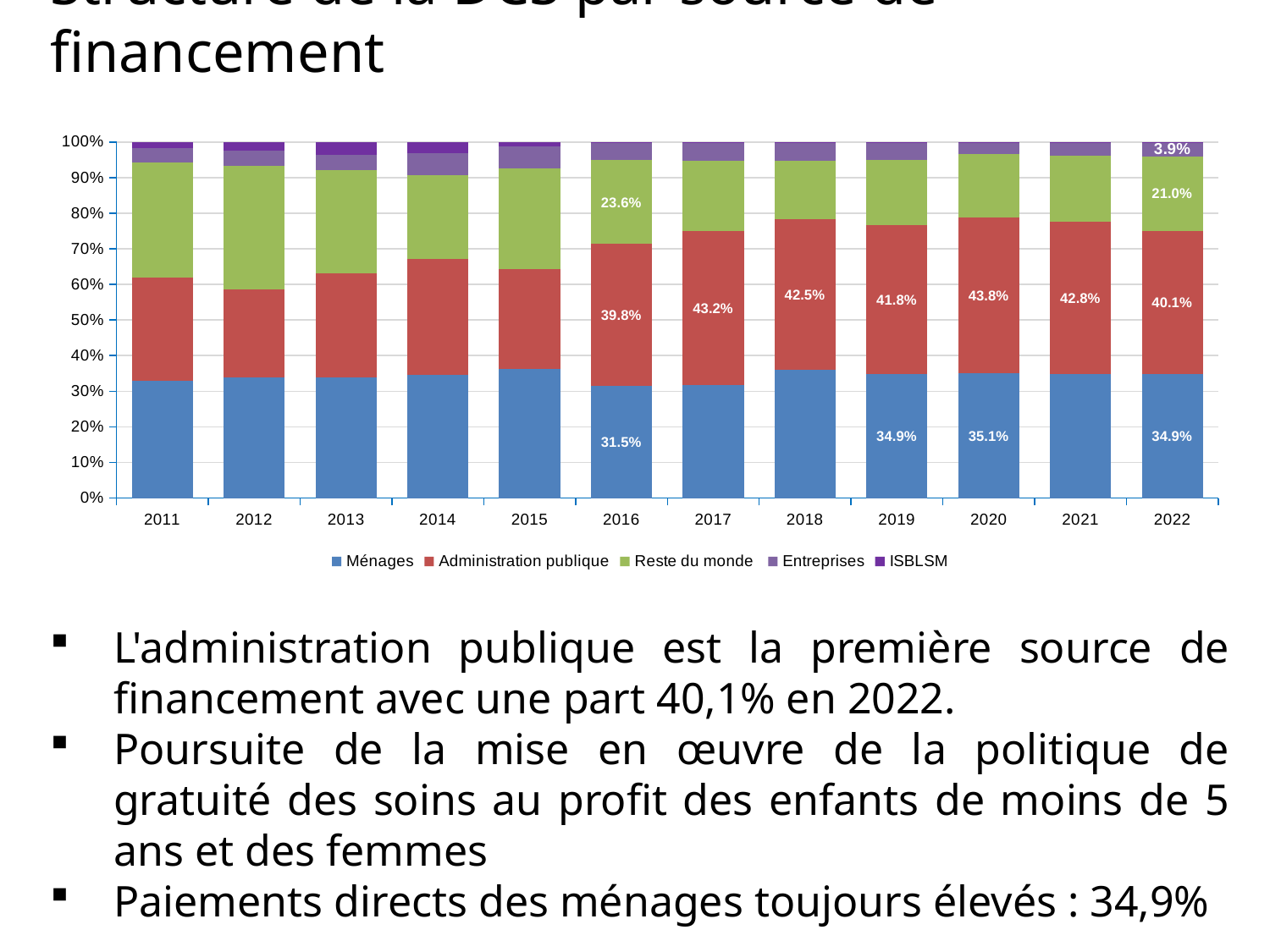
In which year is the Administration publique share the highest? 2020 What is the difference between the Administration publique share in 2020 and in 2022? 3.7 percentage points How many years are shown on the x axis? 12 What is the value for Reste du monde in 2016? 23.6% What is the value for Ménages in 2016? 31.5% What is the difference between the Reste du monde share in 2016 and in 2022? 2.6 percentage points What is the value for Administration publique in 2022? 40.1% What is the value for Entreprises in 2022? 3.9% Is the value for Ménages in 2011 greater or less than 40%? less What kind of chart is shown on the slide? Stacked bar chart How many series does the legend list? 5 Which year has the larger Ménages share, 2019 or 2020? 2020